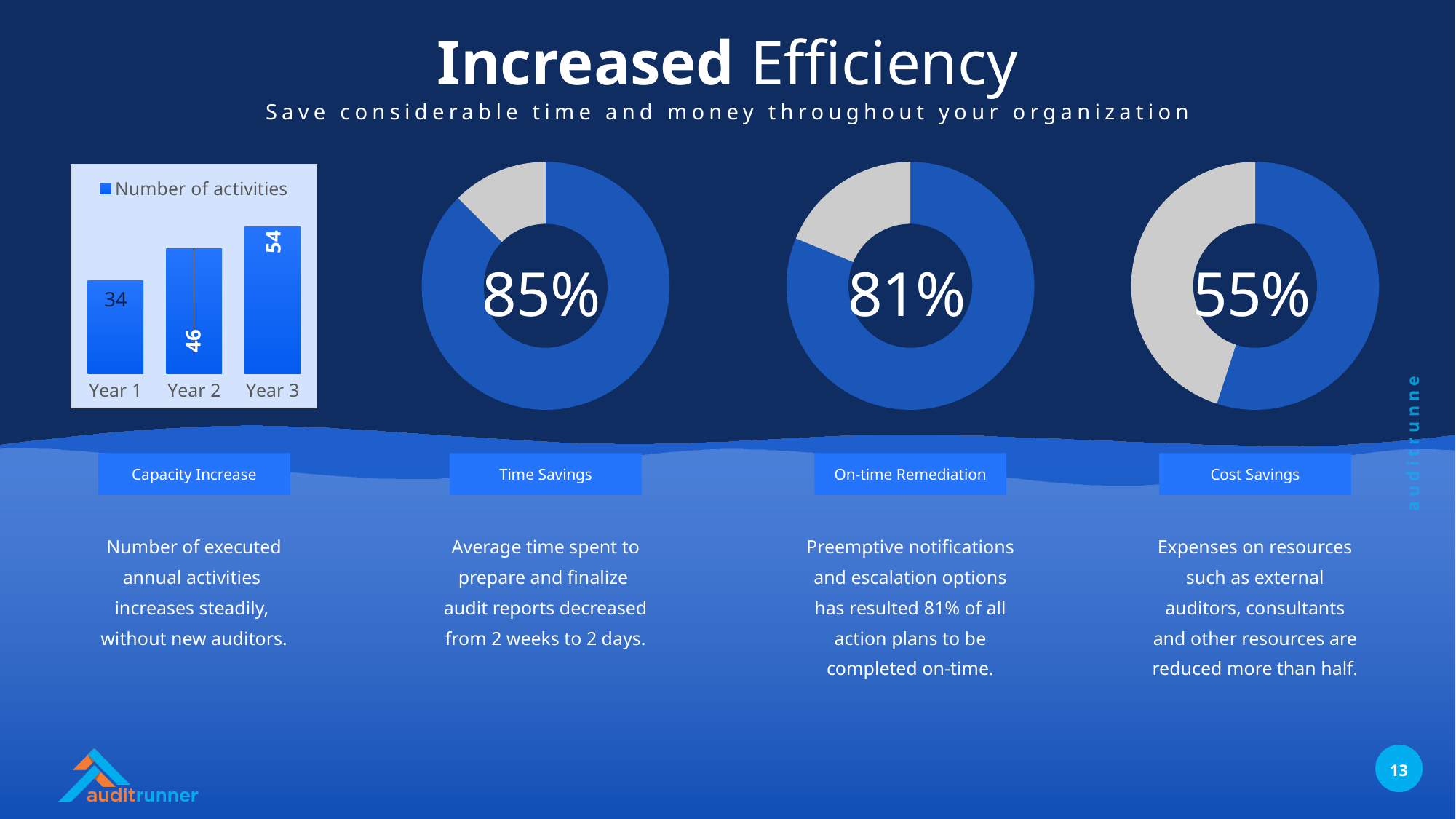
In the bar chart at the left of the slide, which year has the highest number of activities? Year 3 What kind of chart is the chart at the left of the slide showing Year 1 to Year 3? Bar chart How many categories are shown on the x axis of the bar chart at the left of the slide? 3 In the bar chart at the left of the slide, what is the difference between the number of activities in Year 3 and Year 1? 20 How many series does the legend of the bar chart at the left of the slide list? 1 In the bar chart at the left of the slide, which year has the lowest number of activities? Year 1 What percentage is shown in the centre of the donut chart above the 'Cost Savings' label? 55% In the bar chart at the left of the slide, what is the number of activities for Year 3? 54 What percentage is shown in the centre of the donut chart above the 'Time Savings' label? 85% In the bar chart at the left of the slide, what is the number of activities for Year 1? 34 In the bar chart at the left of the slide, is the number of activities larger in Year 2 or Year 1? Year 2 In the bar chart at the left of the slide, do the values rise or fall from Year 1 to Year 3? Rise